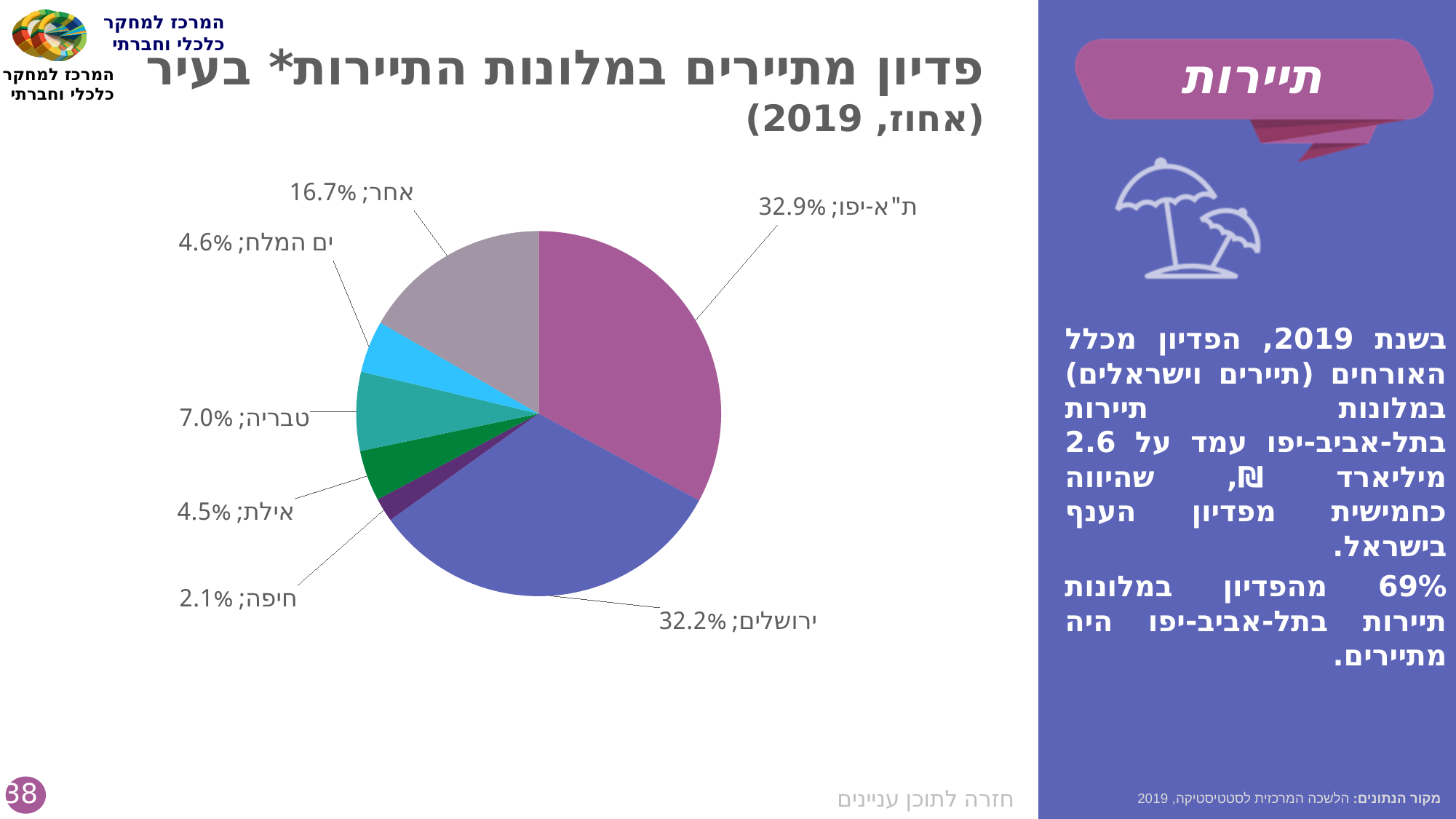
What is the value for ים המלח? 4.6% What is the difference in percentage points between ת"א-יפו and ירושלים? 0.7 What is the value for טבריה? 7.0% Which category has the smallest slice of the pie? חיפה What share of the pie does ת"א-יפו hold? 32.9% What kind of chart is shown on the slide? pie chart Which category has the largest slice of the pie? ת"א-יפו What percentage is labelled for אחר? 16.7% What year is given in the chart's subtitle? 2019 How many slices does the pie chart have? 7 Which is larger, the slice for טבריה or the slice for אילת? טבריה What is the value shown for ירושלים? 32.2%